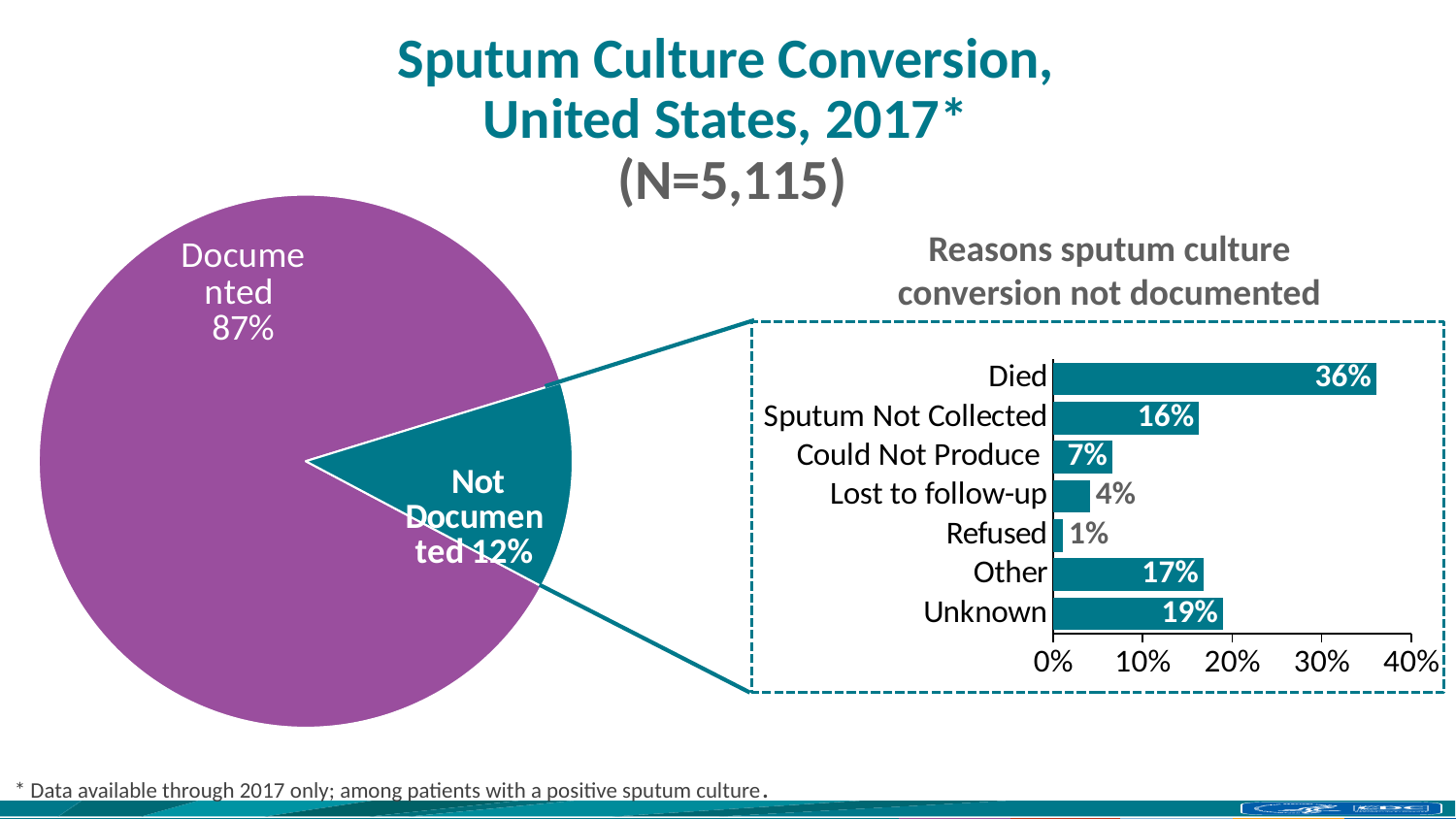
In the pie chart, how many slices are shown? 2 In the bar chart of reasons sputum culture conversion not documented, which reason has the highest value? Died In the pie chart, what share of patients had sputum culture conversion documented? 87% In the bar chart of reasons sputum culture conversion not documented, which reason has the lowest value? Refused In the bar chart of reasons sputum culture conversion not documented, what is the value for Refused? 1% In the bar chart of reasons sputum culture conversion not documented, what is the difference between Unknown and Other? 2% In the bar chart of reasons sputum culture conversion not documented, how many reasons are listed? 7 What type of chart is used to show the reasons sputum culture conversion not documented? Bar chart In the bar chart of reasons sputum culture conversion not documented, what is the value for Sputum Not Collected? 16% In the bar chart of reasons sputum culture conversion not documented, which is larger, Could Not Produce or Lost to follow-up? Could Not Produce In the pie chart, what share of patients had sputum culture conversion not documented? 12% In the bar chart of reasons sputum culture conversion not documented, what is the value for Died? 36%